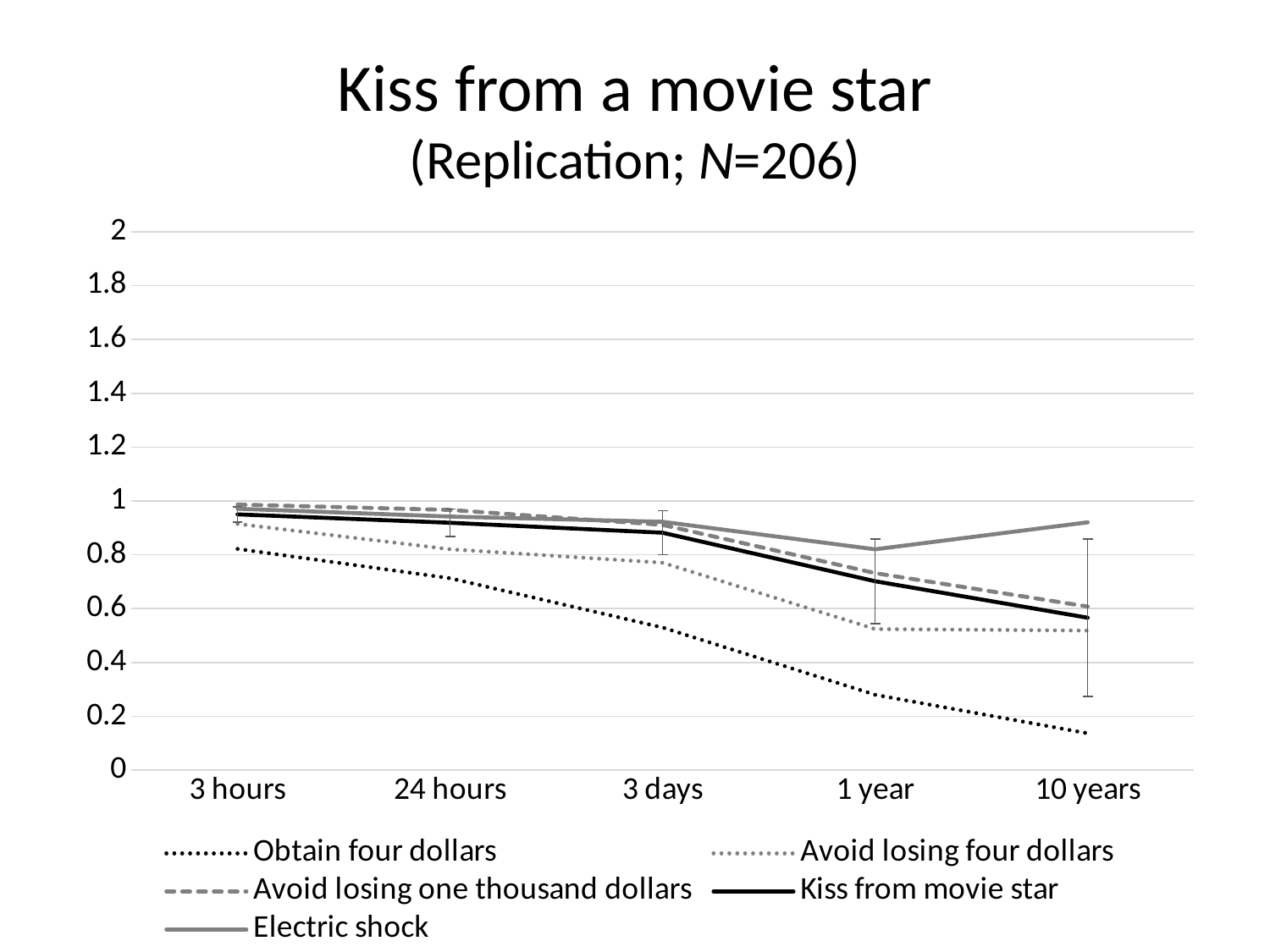
Which series has the lowest value at 3 hours? Obtain four dollars Which series has the lowest value at 10 years? Obtain four dollars Does the Obtain four dollars series rise or fall from 3 hours to 10 years? fall What kind of chart is shown on the slide? line chart What is the title of the chart? Kiss from a movie star (Replication; N=206) At 1 year, which is larger: Electric shock or Obtain four dollars? Electric shock Is the value for Electric shock at 10 years greater or less than 0.8? greater Is the value for Obtain four dollars at 10 years greater or less than 0.2? less Which series has the highest value at 10 years? Electric shock How many series does the legend list? 5 How many time points are shown on the x axis? 5 Is the value for Avoid losing four dollars at 10 years greater or less than 0.4? greater